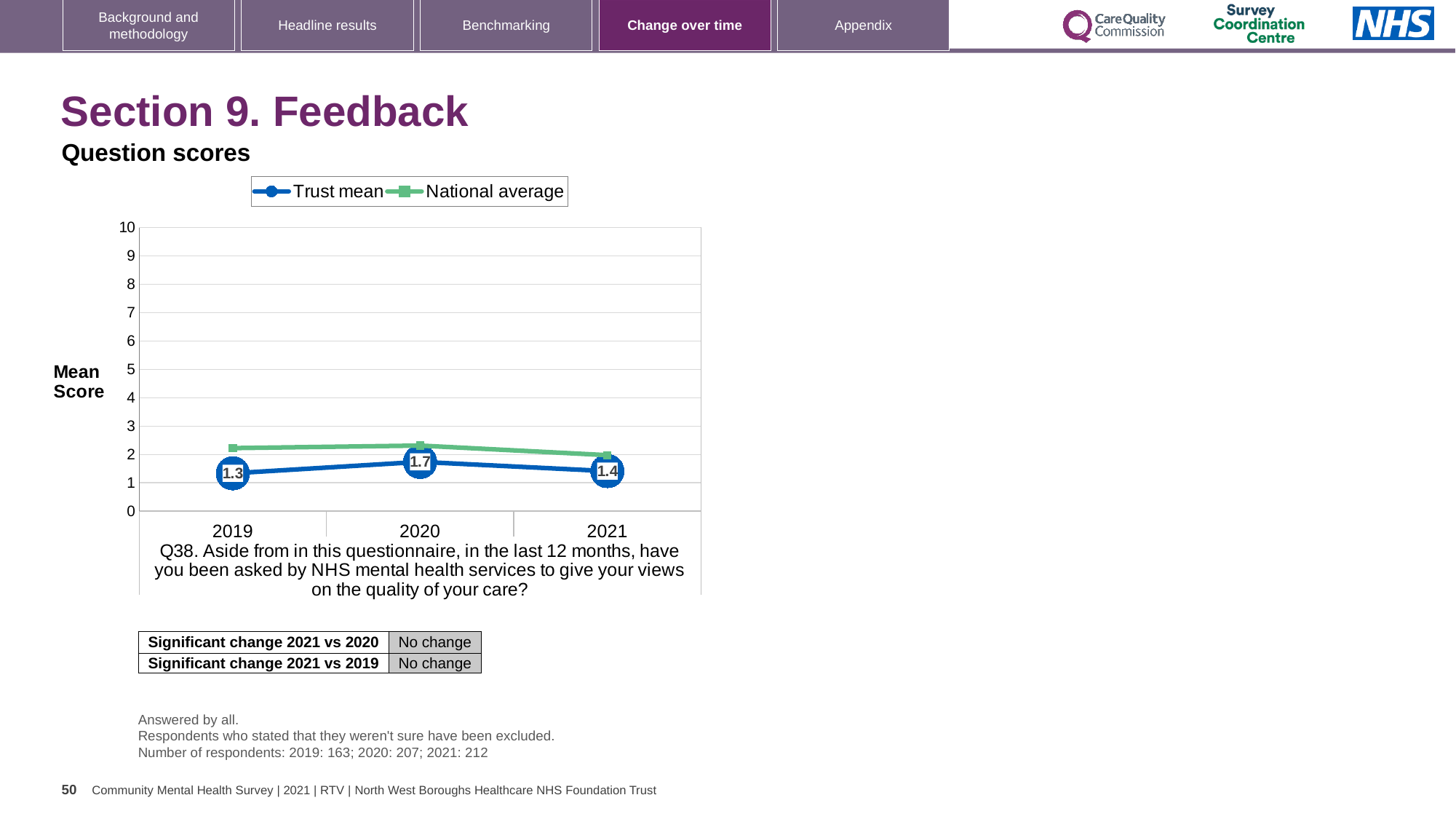
In 2020, which is higher: the Trust mean or the National average? National average How many years are plotted on the x axis? 3 In which year is the Trust mean score highest? 2020 How many series does the legend list? 2 What is the Trust mean score for 2021? 1.4 What is the Trust mean score for 2019? 1.3 What kind of chart is shown on the slide? Line chart What is the Trust mean score for 2020? 1.7 What is the difference between the Trust mean scores for 2020 and 2019? 0.4 Is the National average for 2020 greater or less than 3? less What is the difference between the Trust mean scores for 2020 and 2021? 0.3 In which year is the Trust mean score lowest? 2019